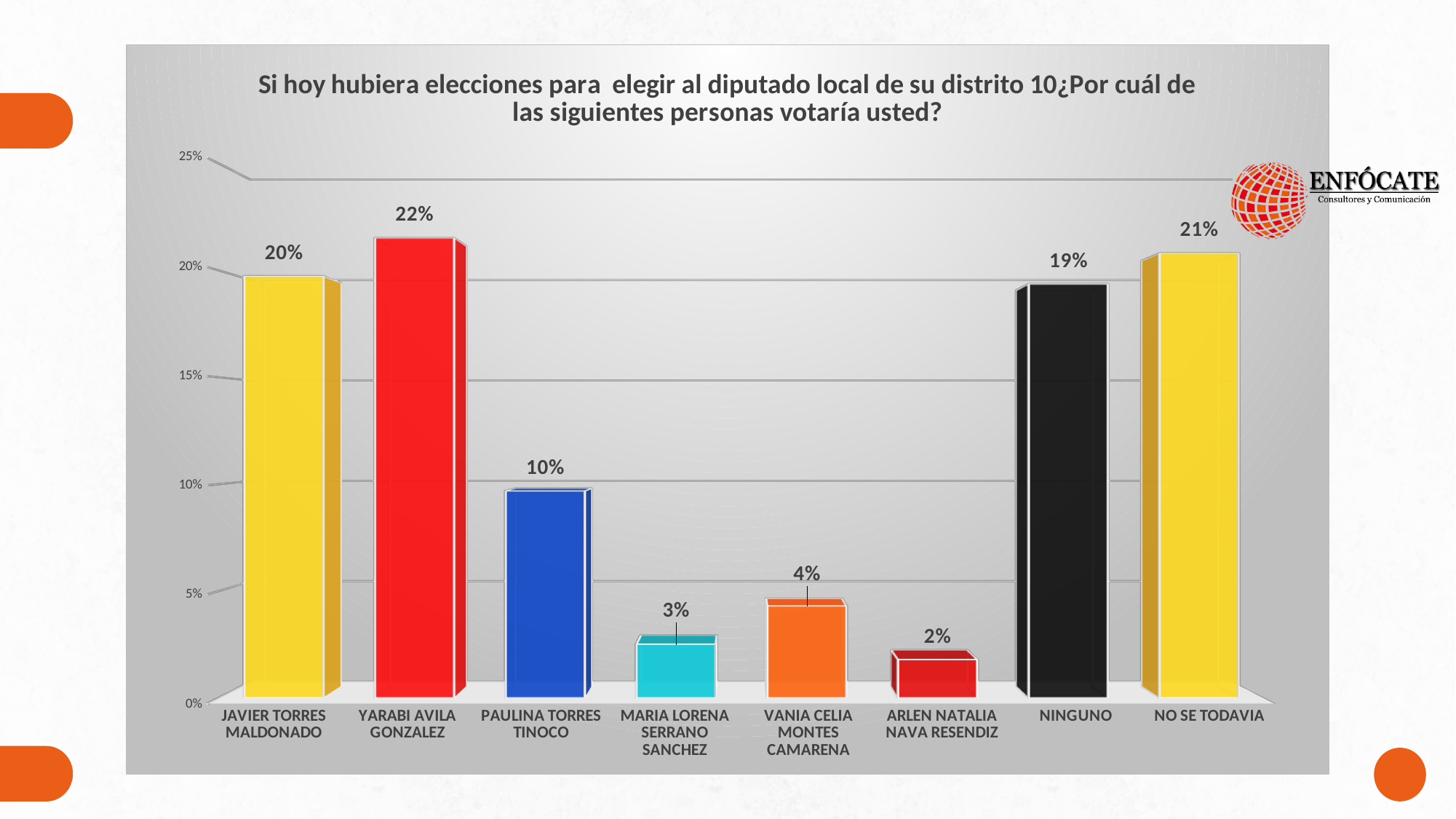
What colour is the bar for 'Ninguno'? Black Which category has the highest value? Yarabi Avila Gonzalez What is the difference between the values for Yarabi Avila Gonzalez and Paulina Torres Tinoco? 12% What is the difference between the values for 'No se todavia' and 'Ninguno'? 2% What percentage of respondents would vote for Javier Torres Maldonado? 20% What percentage is shown for Paulina Torres Tinoco? 10% What value is shown for Yarabi Avila Gonzalez? 22% Which category has the lowest value? Arlen Natalia Nava Resendiz Which is larger, the value for Vania Celia Montes Camarena or Maria Lorena Serrano Sanchez? Vania Celia Montes Camarena How many categories are shown on the x axis? 8 What value is shown for the 'Ninguno' category? 19% What kind of chart is shown on the slide? Bar chart